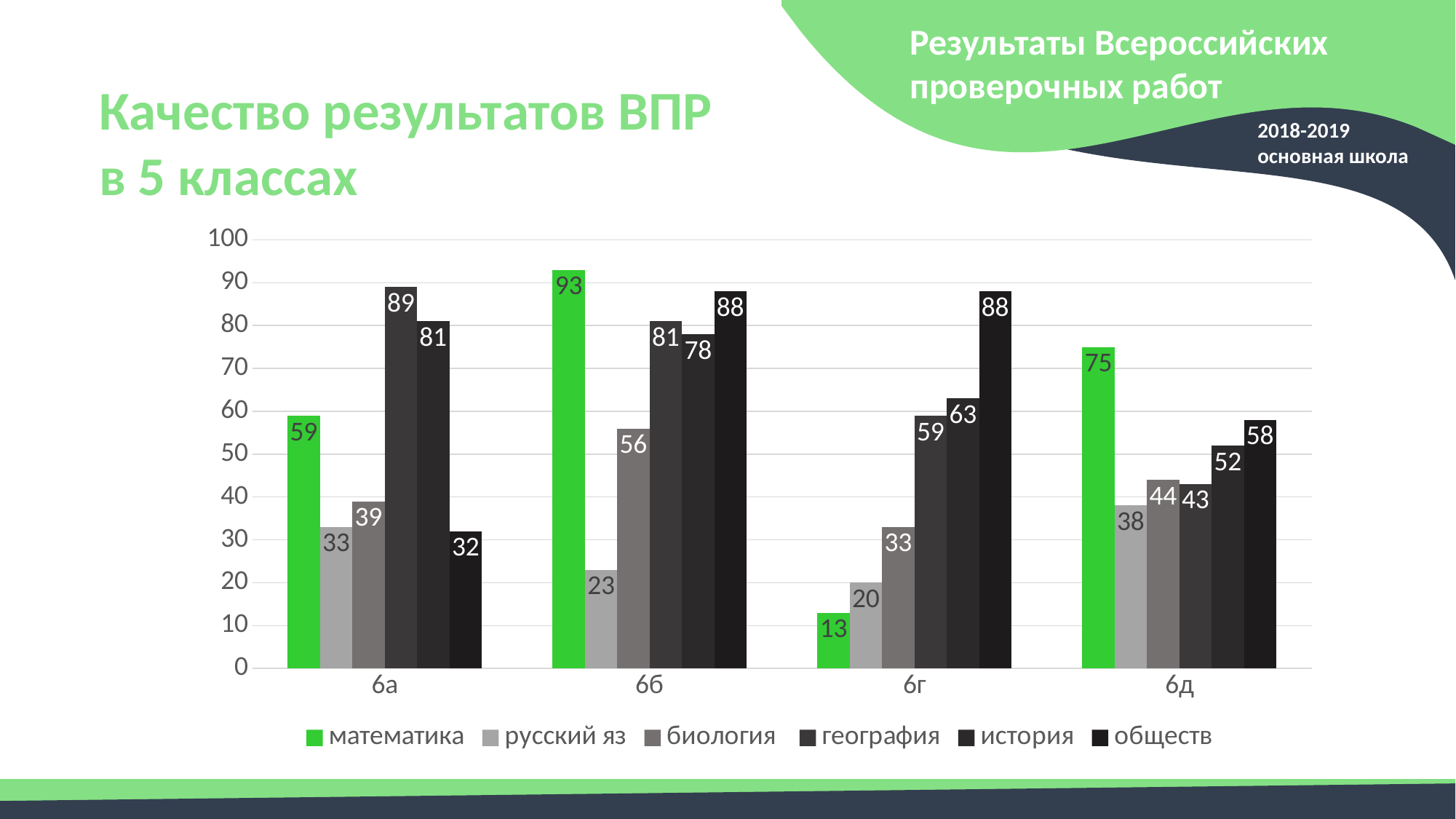
What is the value for обществ in class 6д? 58 Which class has the highest value for математика? 6б What colour are the bars for математика? green How many series does the legend list? 6 Which is larger in class 6а: the value for история or the value for обществ? история What kind of chart is shown on the slide? bar chart What is the difference between the математика values for 6б and 6г? 80 What is the value for география in class 6а? 89 What is the value for русский яз in class 6г? 20 How many classes are shown on the x axis? 4 What is the value for математика in class 6б? 93 Which class has the lowest value for математика? 6г